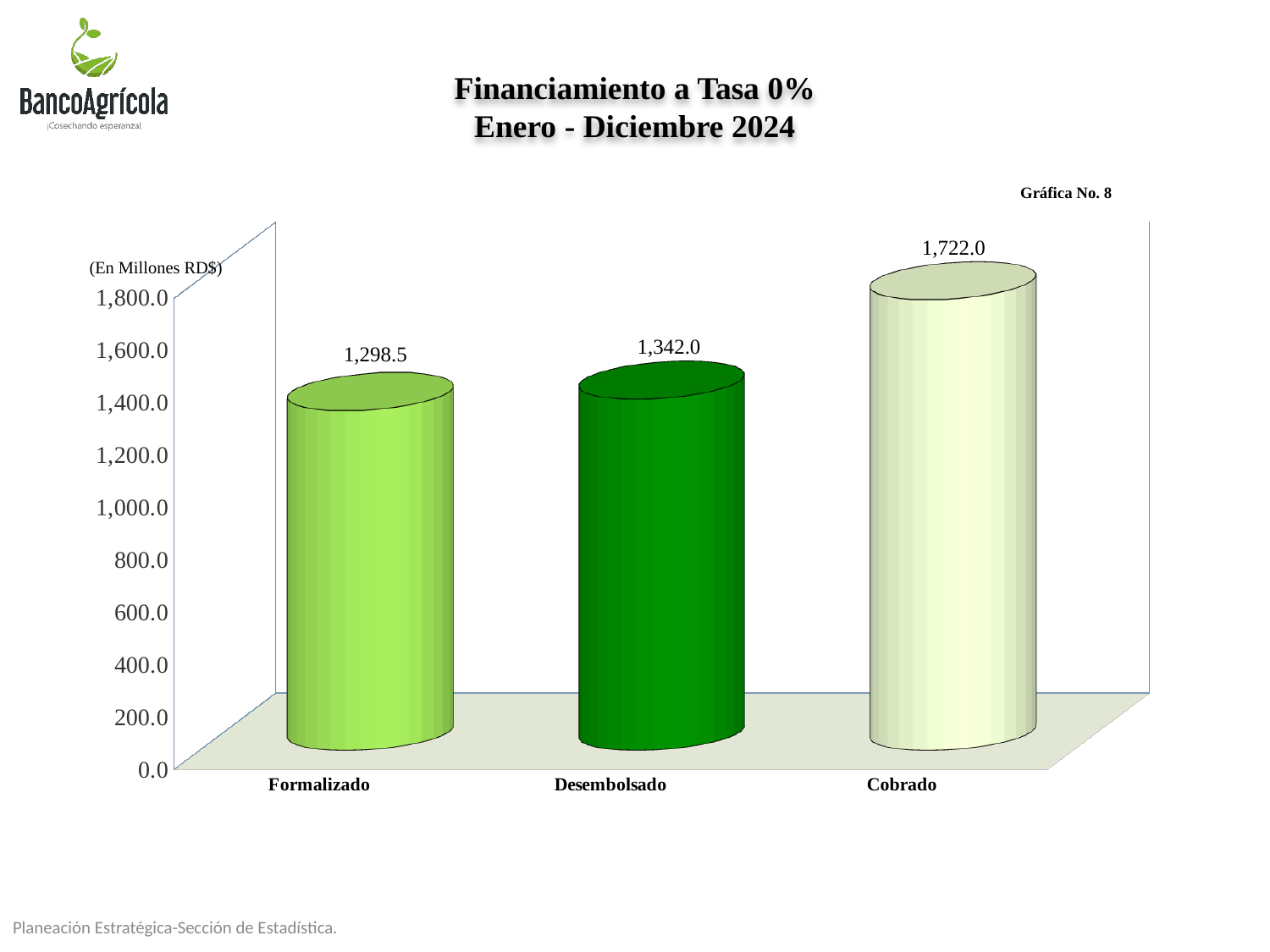
Which is larger, the value for Cobrado or the value for Desembolsado? Cobrado What is the difference between the values for Desembolsado and Formalizado? 43.5 Which category has the highest value? Cobrado What is the value for Desembolsado? 1,342.0 How many categories are shown on the chart? 3 What is the difference between the values for Cobrado and Formalizado? 423.5 Which category has the lowest value? Formalizado What is the value for Formalizado? 1,298.5 What unit is stated for the values on the chart? En Millones RD$ What is the value for Cobrado? 1,722.0 Is the value for Cobrado greater or less than 1,600.0? greater What kind of chart is shown on the slide? bar chart